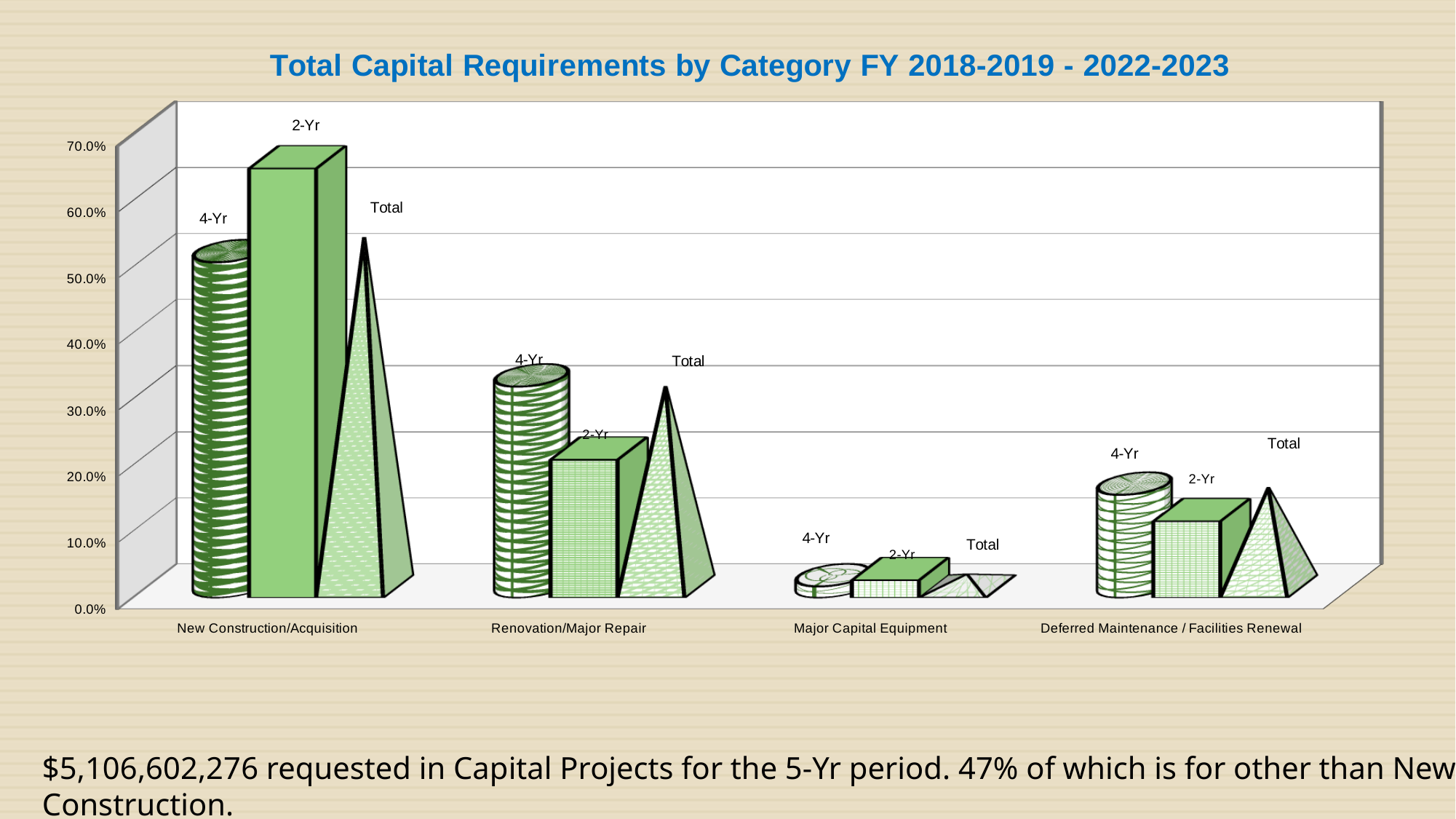
Is the 2-Yr value for Deferred Maintenance / Facilities Renewal greater or less than 20.0%? less What is the title of the chart? Total Capital Requirements by Category FY 2018-2019 - 2022-2023 What kind of chart is shown on the slide? bar chart Is the 2-Yr value for New Construction/Acquisition greater or less than 60.0%? greater Which category has the highest 2-Yr value? New Construction/Acquisition Which category has the highest Total value? New Construction/Acquisition Is the 4-Yr value for Major Capital Equipment greater or less than 10.0%? less For Renovation/Major Repair, which is larger: the 4-Yr value or the 2-Yr value? 4-Yr How many series (4-Yr, 2-Yr, Total) are plotted for each category? 3 How many categories are shown along the x axis of the chart? 4 Which category has the lowest 4-Yr value? Major Capital Equipment